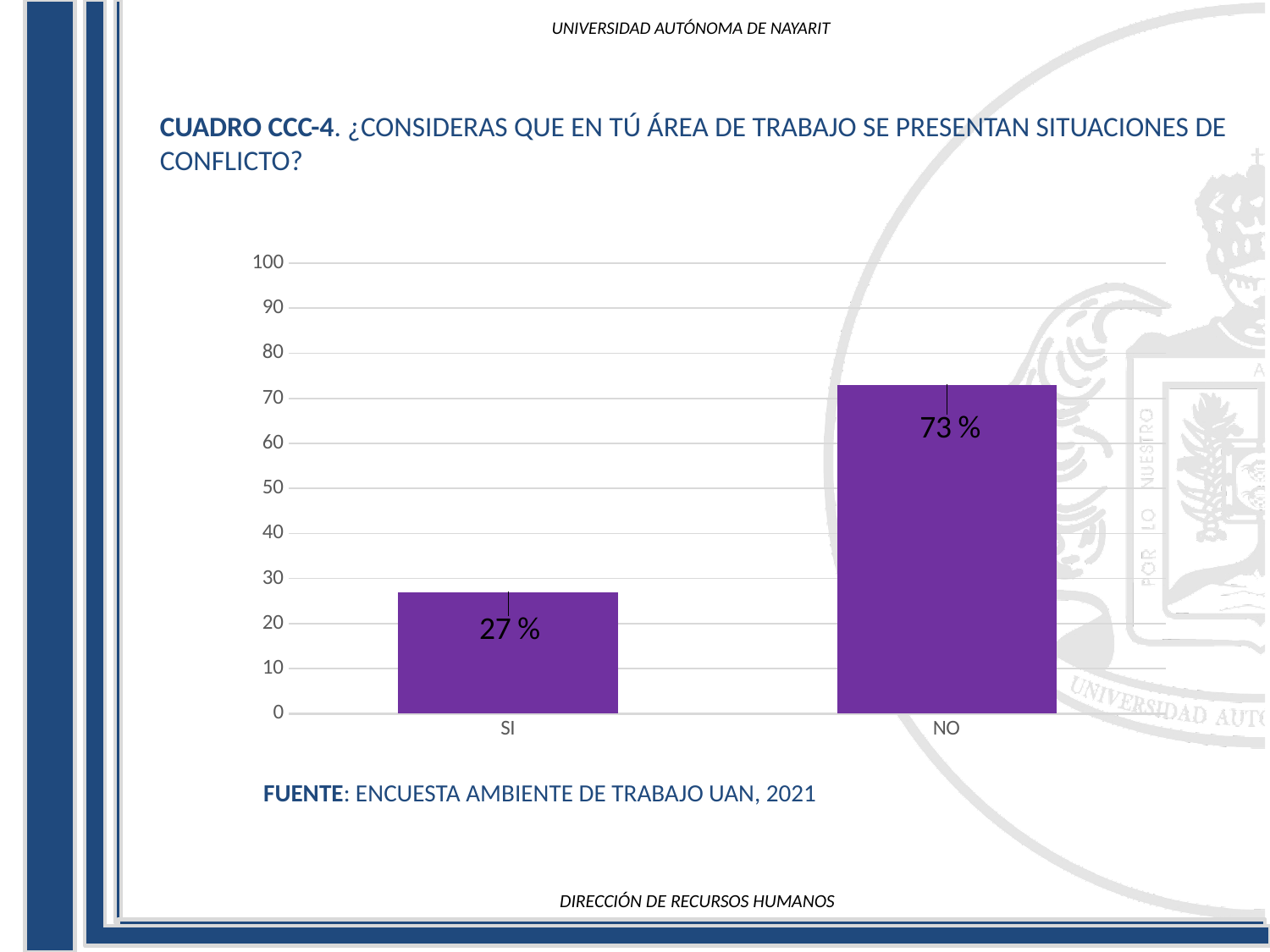
What is the value for SI? 27 % What is the difference between the values for NO and SI? 46 % Which is larger, the value for SI or the value for NO? NO What kind of chart is shown on the slide? bar chart What is the highest value shown on the y axis? 100 How many categories are shown on the x axis? 2 Which category has the lowest value? SI Is the value for SI greater or less than 30? less Is the value for NO greater or less than 70? greater What is the value for NO? 73 % Which category has the highest value? NO What is the source cited below the chart? ENCUESTA AMBIENTE DE TRABAJO UAN, 2021